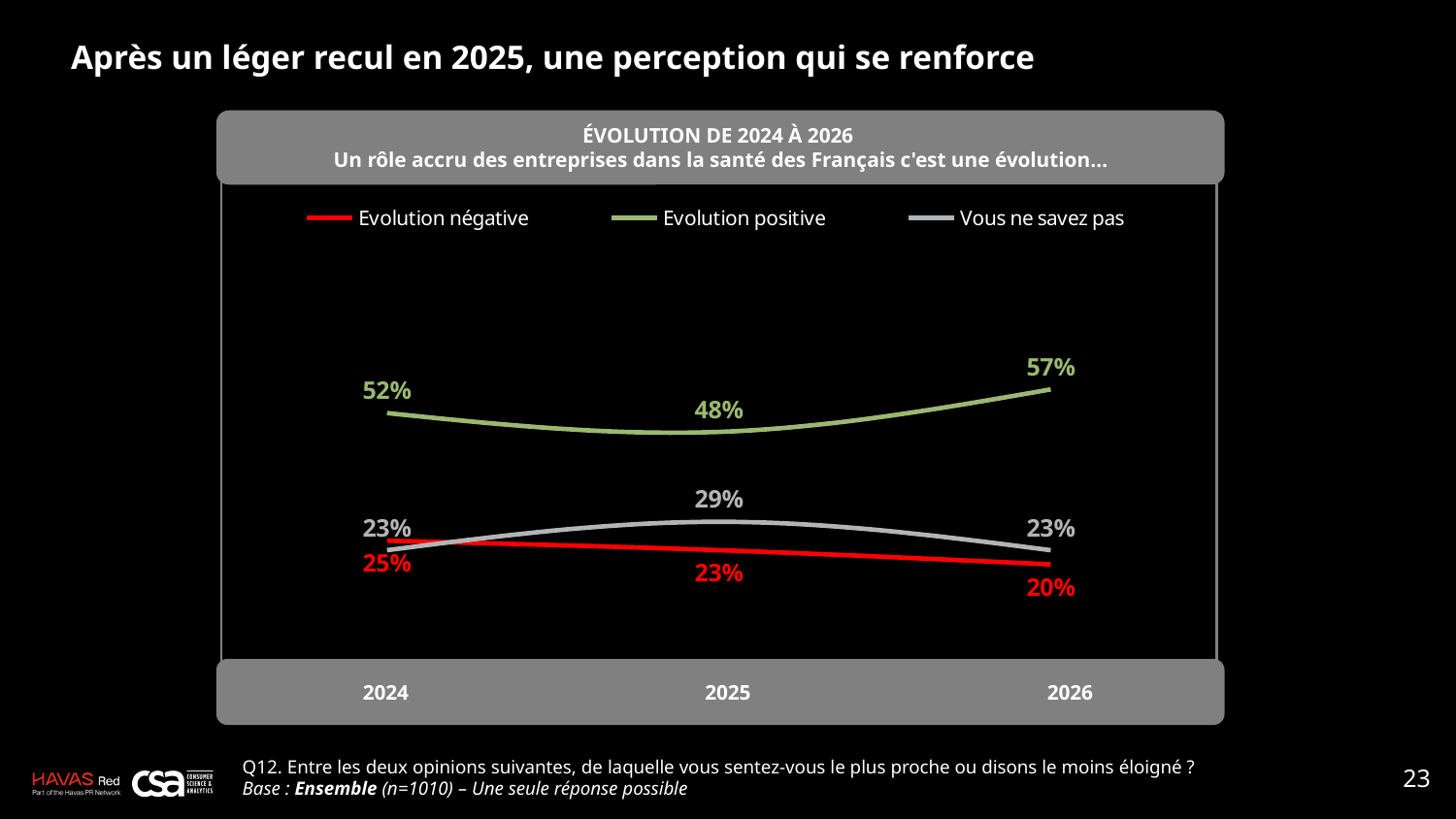
What is the value for Evolution négative in 2024? 25% What is the difference between Evolution positive in 2026 and in 2025? 9 percentage points Which is larger in 2024: Evolution négative or Vous ne savez pas? Evolution négative What is the value for Evolution positive in 2026? 57% What is the value for Evolution négative in 2026? 20% How many series does the legend list? 3 What is the value for Vous ne savez pas in 2025? 29% Does Evolution négative rise or fall from 2024 to 2026? Fall In which year is Vous ne savez pas at its highest? 2025 What type of chart is shown? Line chart How many years are shown on the x axis? 3 In which year is Evolution positive at its lowest? 2025